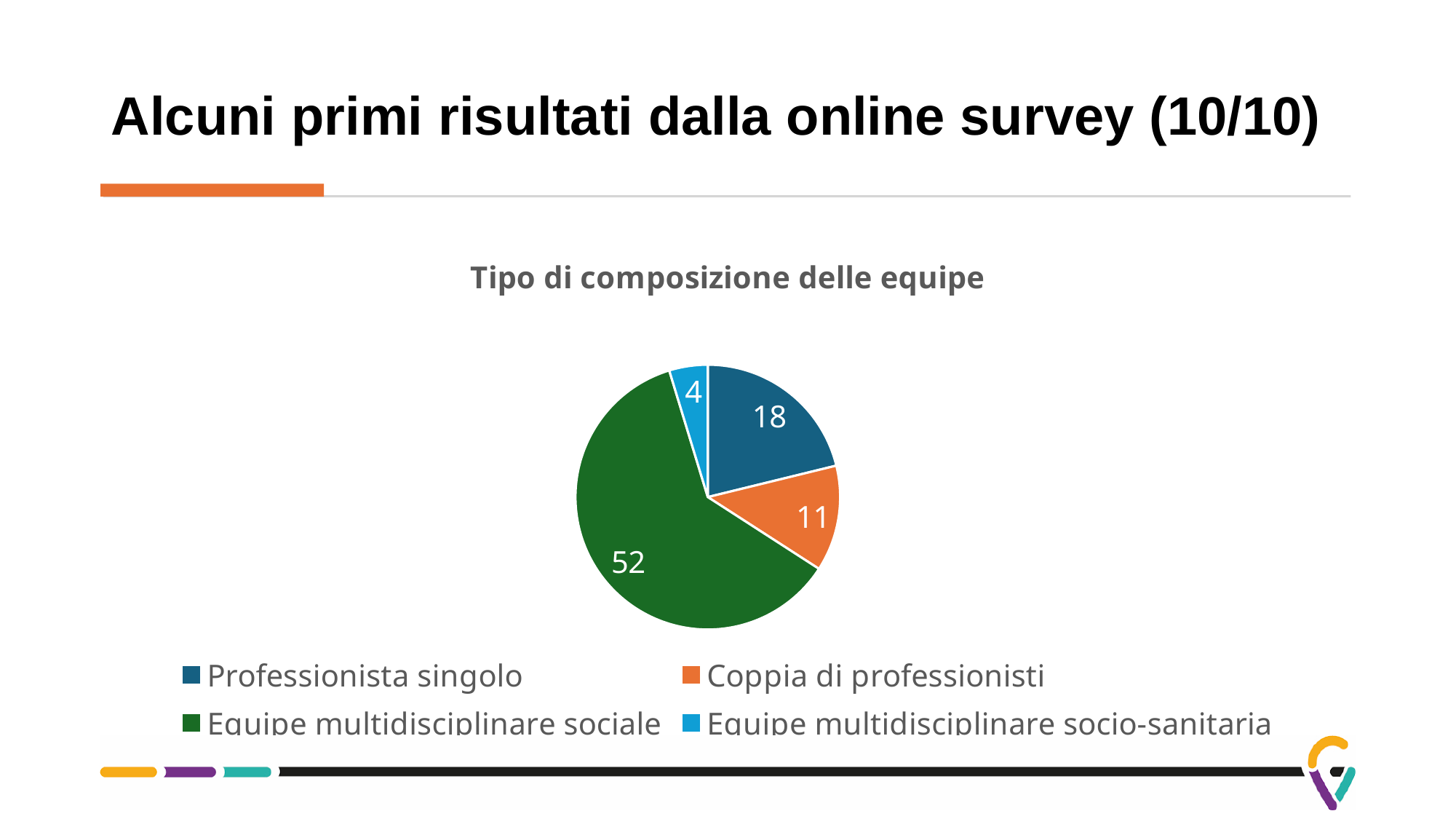
What is the value for Equipe multidisciplinare sociale? 52 What is the value for Professionista singolo? 18 What is the value for Equipe multidisciplinare socio-sanitaria? 4 What colour is the slice for Coppia di professionisti? orange Which category has the largest slice of the pie? Equipe multidisciplinare sociale How many categories does the pie chart have? 4 What is the value for Coppia di professionisti? 11 What is the title of the chart? Tipo di composizione delle equipe What is the difference between the values for Equipe multidisciplinare sociale and Professionista singolo? 34 Which is larger, the value for Professionista singolo or the value for Coppia di professionisti? Professionista singolo Which category has the smallest slice of the pie? Equipe multidisciplinare socio-sanitaria What type of chart is shown on the slide? pie chart